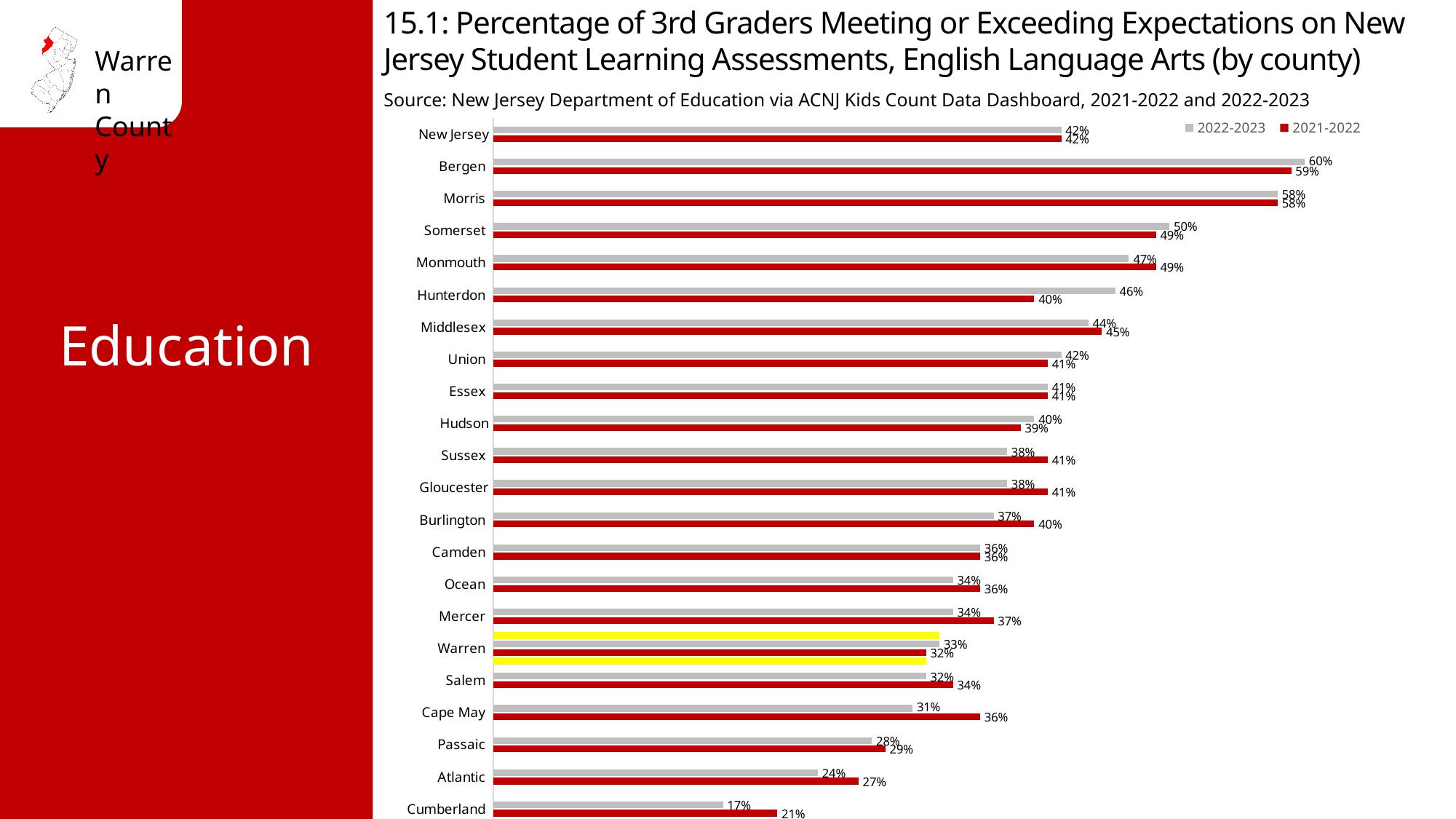
What kind of chart is shown on the slide? Bar chart What is the difference between the 2022-2023 and 2021-2022 values for Hunterdon? 6% Which county's bars are highlighted in yellow? Warren How many series does the legend list? 2 What is the 2021-2022 value for Hunterdon? 40% Which is larger for Cape May: the 2022-2023 value or the 2021-2022 value? 2021-2022 How many counties or regions are listed on the chart? 22 What is the 2022-2023 value for Cape May? 31% Which county has the highest 2022-2023 value? Bergen What is the difference between the 2022-2023 values for Bergen and Warren? 27% Which county has the lowest 2021-2022 value? Cumberland What is the 2022-2023 value for Warren? 33%